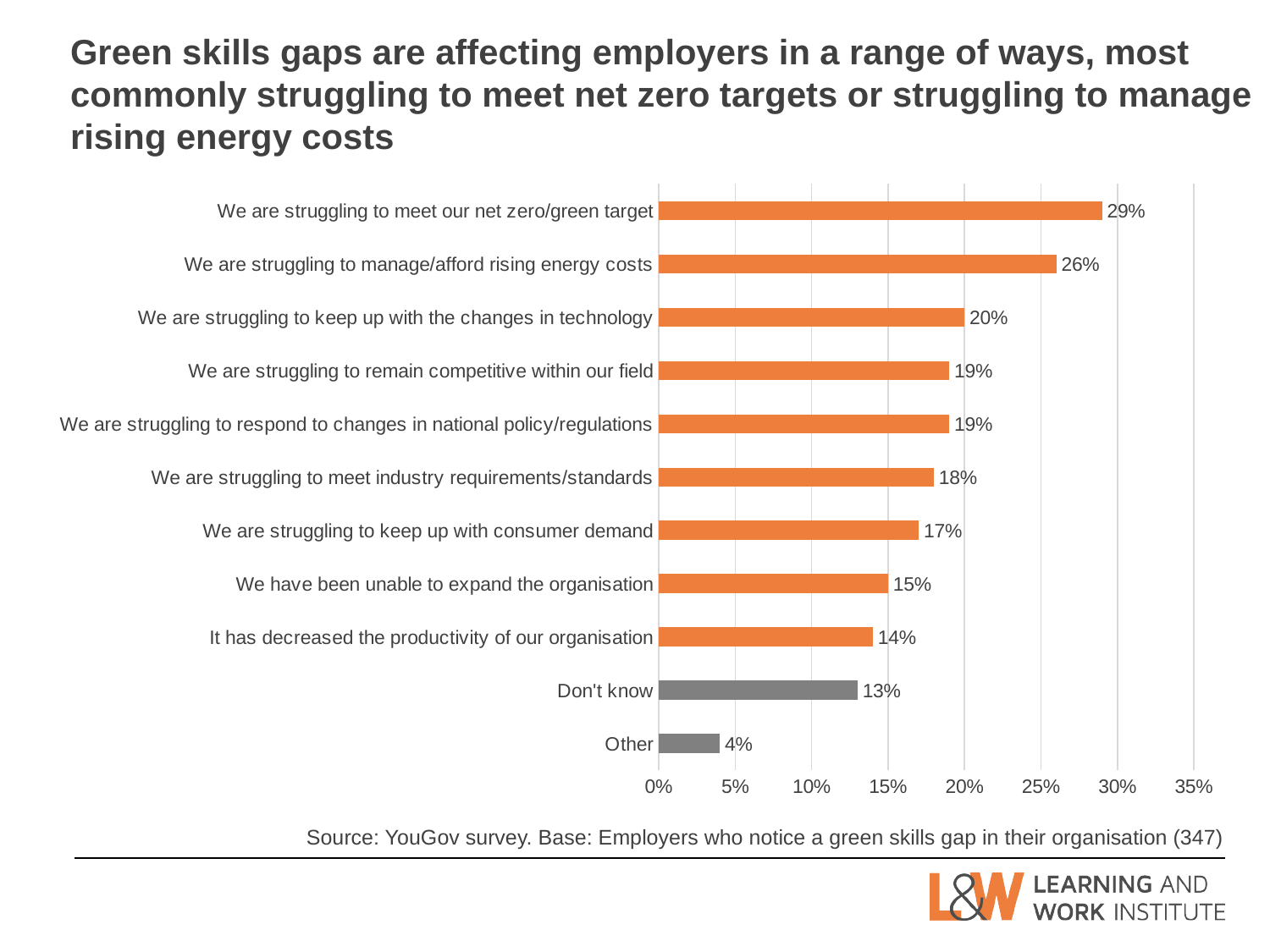
What is the difference between the values for struggling to meet the net zero/green target and struggling to manage/afford rising energy costs? 3% What percentage of employers say they are struggling to meet their net zero/green target? 29% What kind of chart is shown on the slide? Bar chart What is the value for 'We are struggling to manage/afford rising energy costs'? 26% Which category has the highest value? We are struggling to meet our net zero/green target Is the value for 'We are struggling to keep up with the changes in technology' greater or less than 15%? greater How many categories are shown in the chart? 11 What is the base size stated in the source note below the chart? 347 Which is larger: the value for 'We have been unable to expand the organisation' or 'It has decreased the productivity of our organisation'? We have been unable to expand the organisation What percentage of employers answered 'Don't know'? 13% Which category has the lowest value? Other What is the value for 'We are struggling to keep up with consumer demand'? 17%